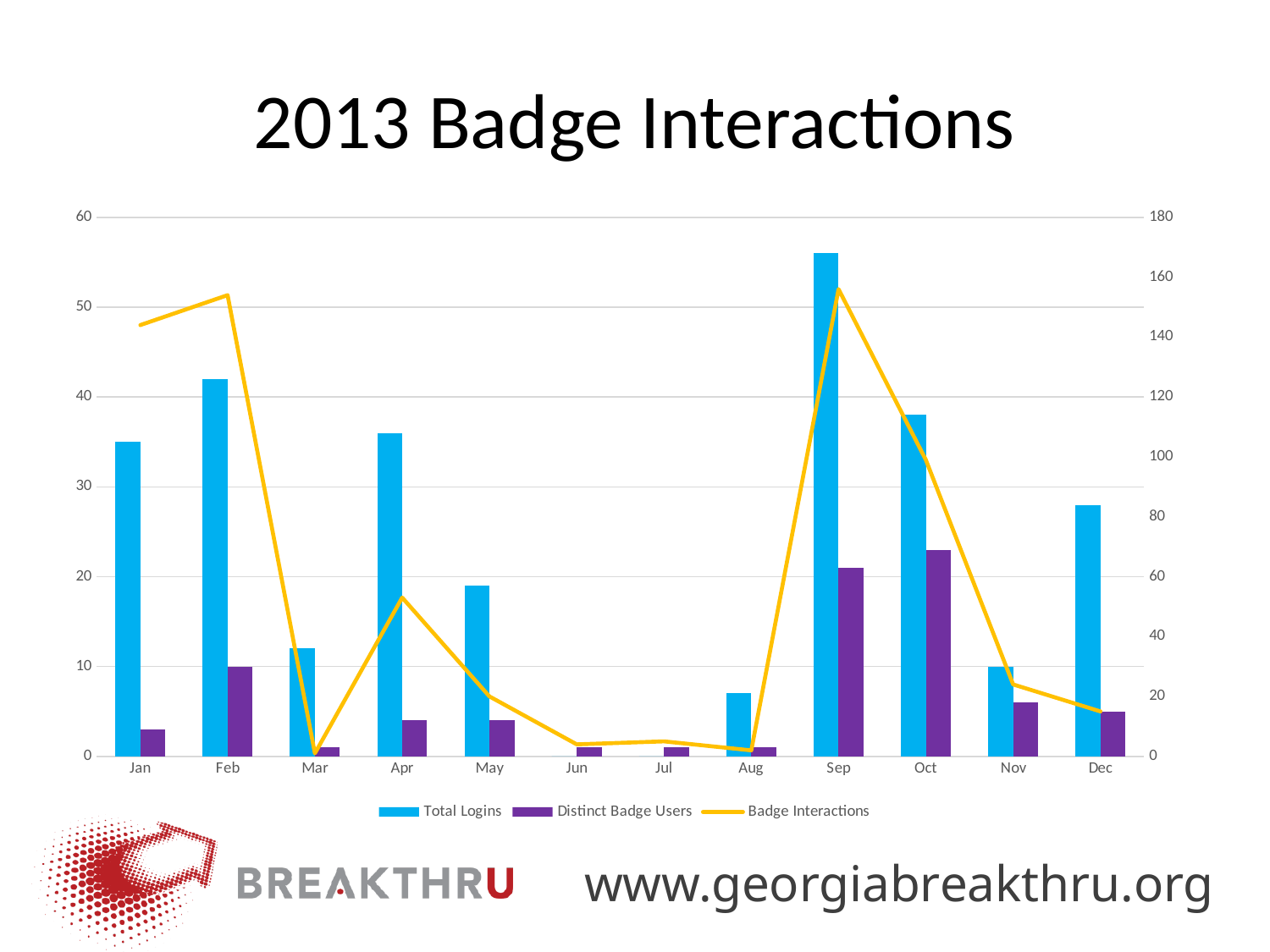
Which month has the highest Total Logins? Sep What kind of chart is this? Combined bar and line chart Is the Total Logins value for Jan greater or less than 40? less How many series does the legend list? 3 Is the Badge Interactions value for Apr greater or less than 40? greater Which is larger, Distinct Badge Users in Feb or Distinct Badge Users in Nov? Feb Is the Badge Interactions value for Feb greater or less than 140? greater How many months are shown on the x axis? 12 Do Badge Interactions rise or fall from Sep to Dec? fall What is the title of the chart? 2013 Badge Interactions Which is larger, Total Logins in Feb or Total Logins in Apr? Feb